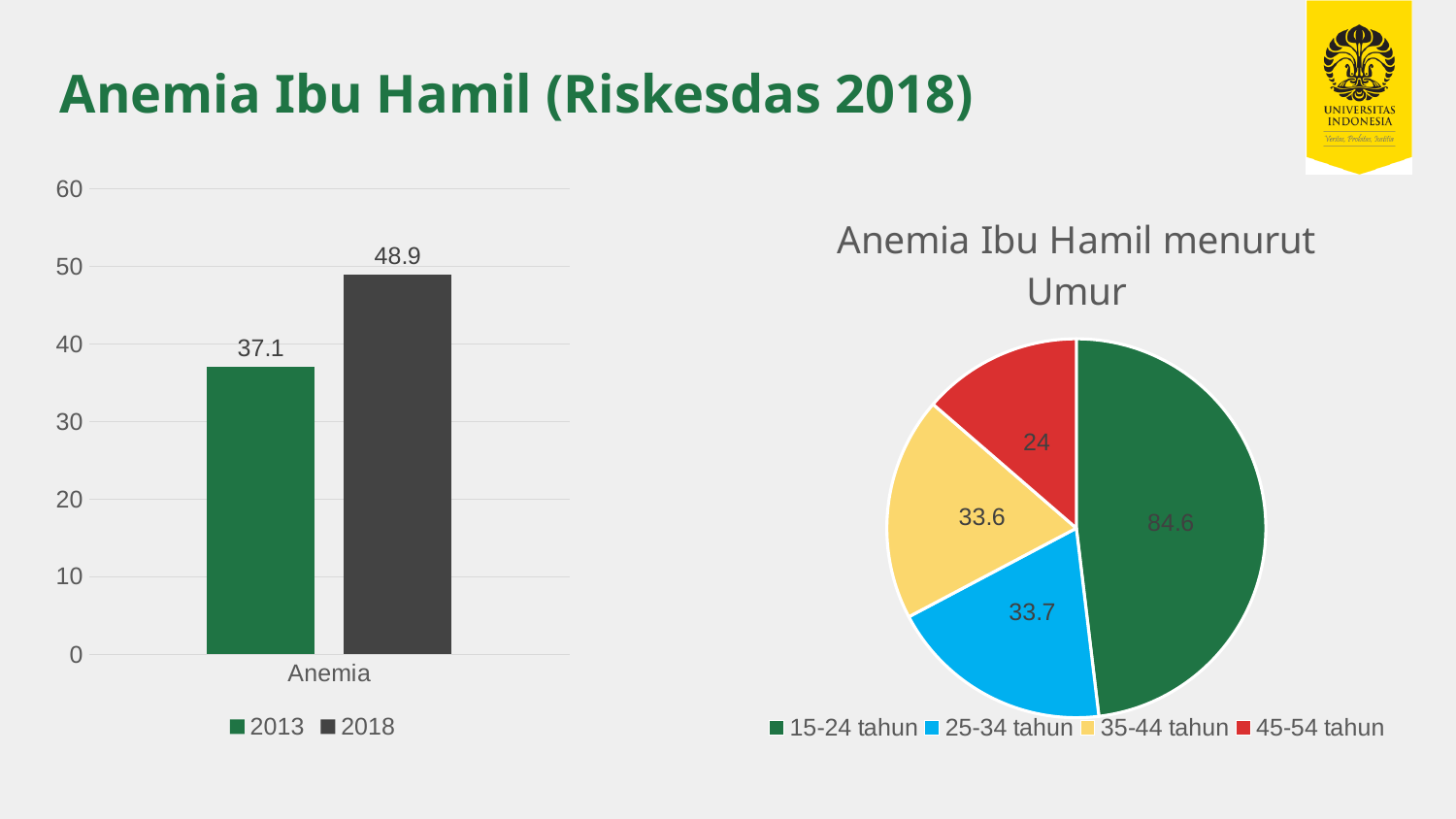
In the bar chart on the left, what is the value for 2013? 37.1 In the bar chart on the left, what is the difference between the 2018 and 2013 values? 11.8 In the chart titled 'Anemia Ibu Hamil menurut Umur', how many age groups are shown? 4 In the bar chart on the left, how many series does the legend list? 2 What kind of chart is the chart on the left of the slide? Bar chart In the chart titled 'Anemia Ibu Hamil menurut Umur', what is the value for 45-54 tahun? 24 What kind of chart is 'Anemia Ibu Hamil menurut Umur'? Pie chart In the chart titled 'Anemia Ibu Hamil menurut Umur', which age group has the largest slice? 15-24 tahun In the chart titled 'Anemia Ibu Hamil menurut Umur', which age group has the smallest slice? 45-54 tahun In the bar chart on the left, which series has the higher value, 2013 or 2018? 2018 In the chart titled 'Anemia Ibu Hamil menurut Umur', what is the value for 15-24 tahun? 84.6 In the bar chart on the left, what is the value for 2018? 48.9